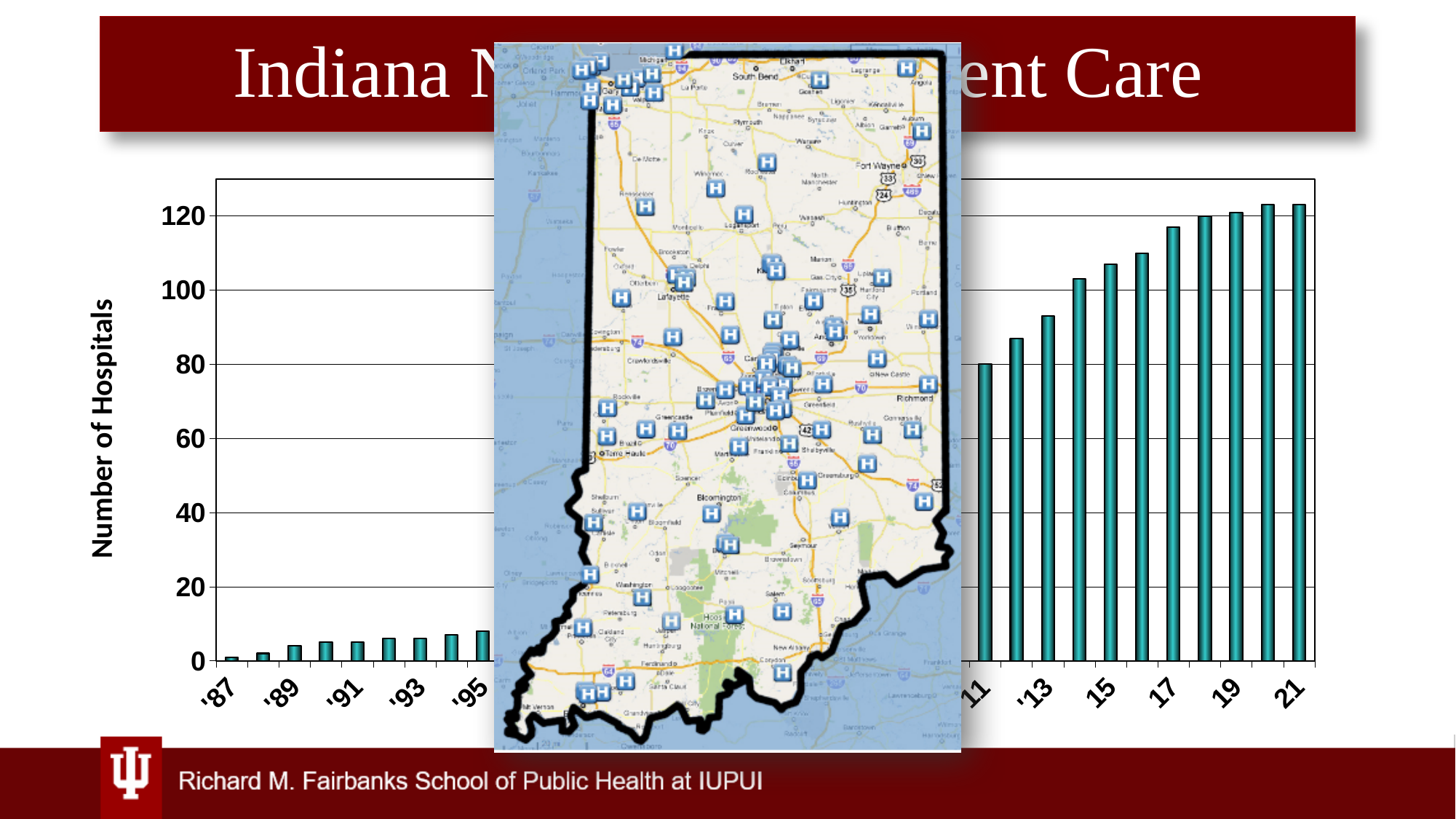
Which has the larger value, '13 or '17? '17 Is the value for '95 greater or less than 20? less Is the value for '13 greater or less than 100? less Do the values rise or fall from '87 to '95? rise What is the label of the vertical axis of the chart? Number of Hospitals What kind of chart is shown on the slide? bar chart Is the value for '87 greater or less than 20? less Which has the larger value, '87 or '21? '21 Do the values rise or fall from '11 to '21? rise